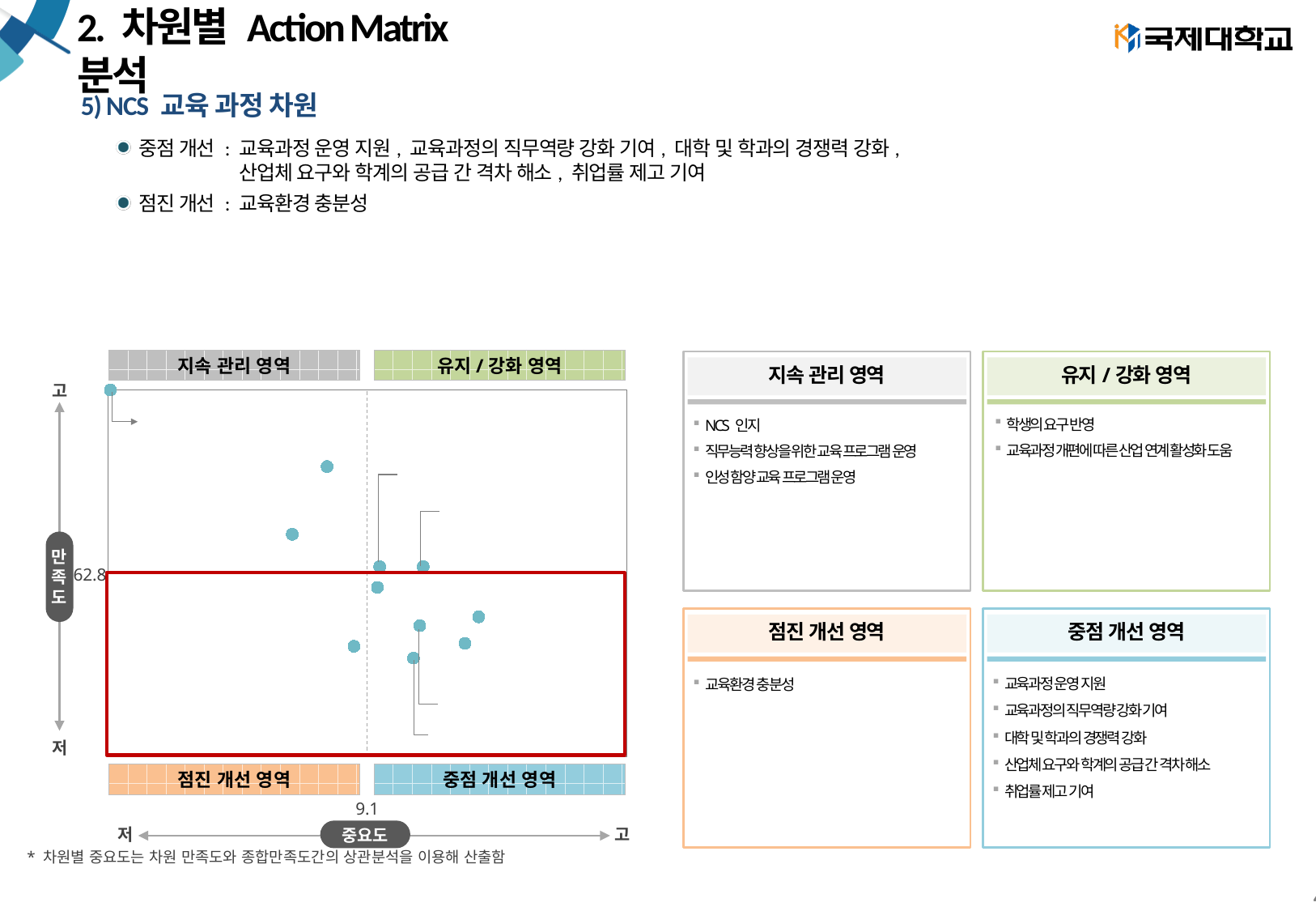
What kind of chart is shown on the left of the slide? scatter chart How many points fall in the 점진 개선 영역 (lower-left) quadrant of the scatter chart? 1 Which quadrant of the scatter chart contains the most points? 중점 개선 영역 What value marks the vertical reference line on the 중요도 axis of the scatter chart? 9.1 Which quadrant of the scatter chart is outlined with a red box? 점진 개선 영역 and 중점 개선 영역 (the whole lower half) What value marks the horizontal reference line on the 만족도 axis of the scatter chart? 62.8 Which quadrant label appears in the upper-left of the scatter chart? 지속 관리 영역 What is the label of the vertical axis of the scatter chart? 만족도 Which quadrant label appears in the upper-right of the scatter chart? 유지 / 강화 영역